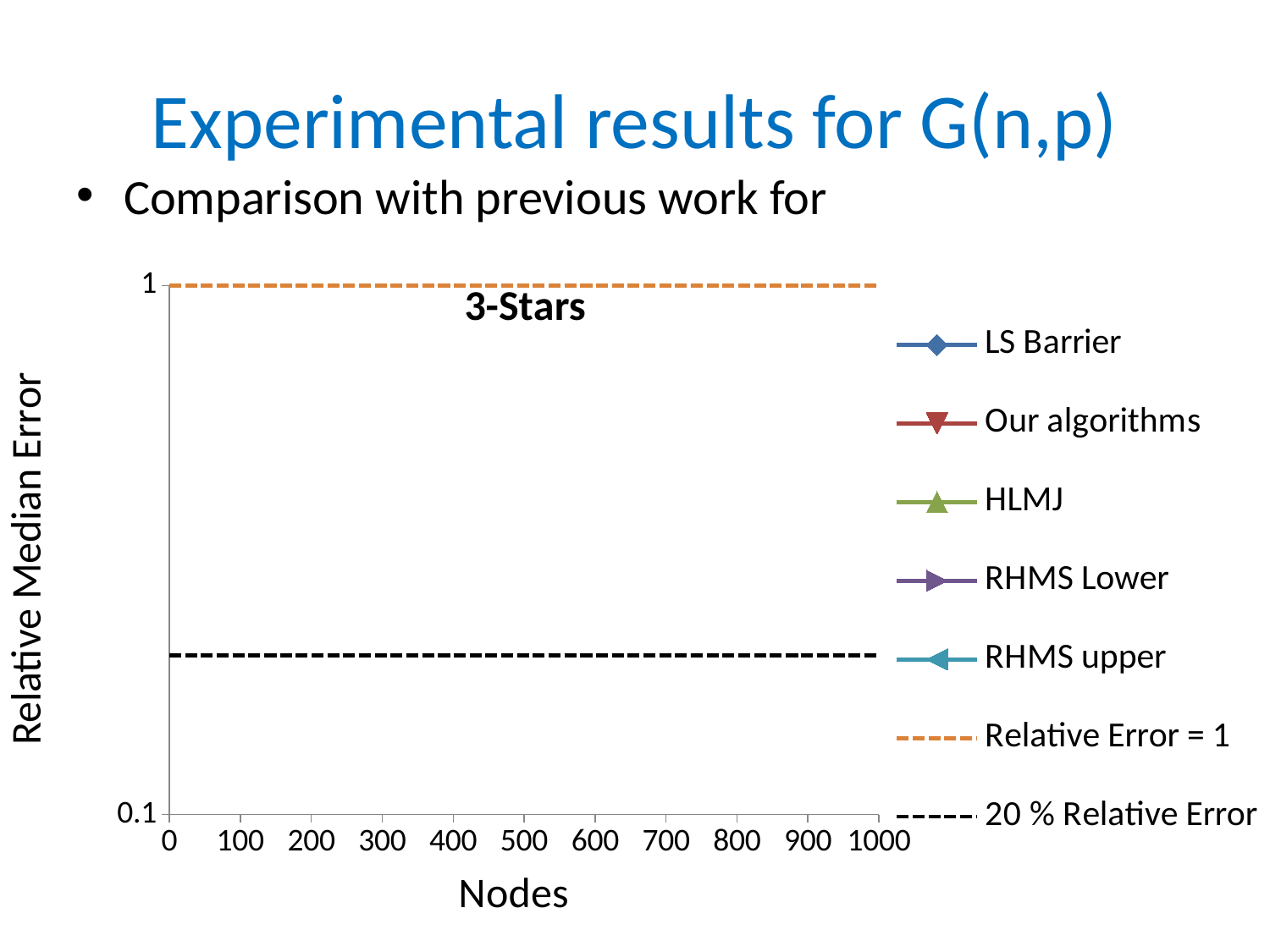
Does the '20 % Relative Error' line rise, fall, or stay flat as Nodes increases? stay flat What is the title of the chart? 3-Stars What kind of chart is shown on the slide? line chart Is the value of the '20 % Relative Error' line greater or less than 0.1? greater At what value on the y axis does the 'Relative Error = 1' dashed line sit? 1 What is the label of the y axis? Relative Median Error Does the 'Relative Error = 1' line rise, fall, or stay flat as Nodes increases? stay flat Which line is higher on the chart, 'Relative Error = 1' or '20 % Relative Error'? Relative Error = 1 What is the lowest value shown on the y axis? 0.1 What is the largest value shown on the x axis (Nodes)? 1000 Is the value of the '20 % Relative Error' line greater or less than 1? less How many series does the legend list? 7